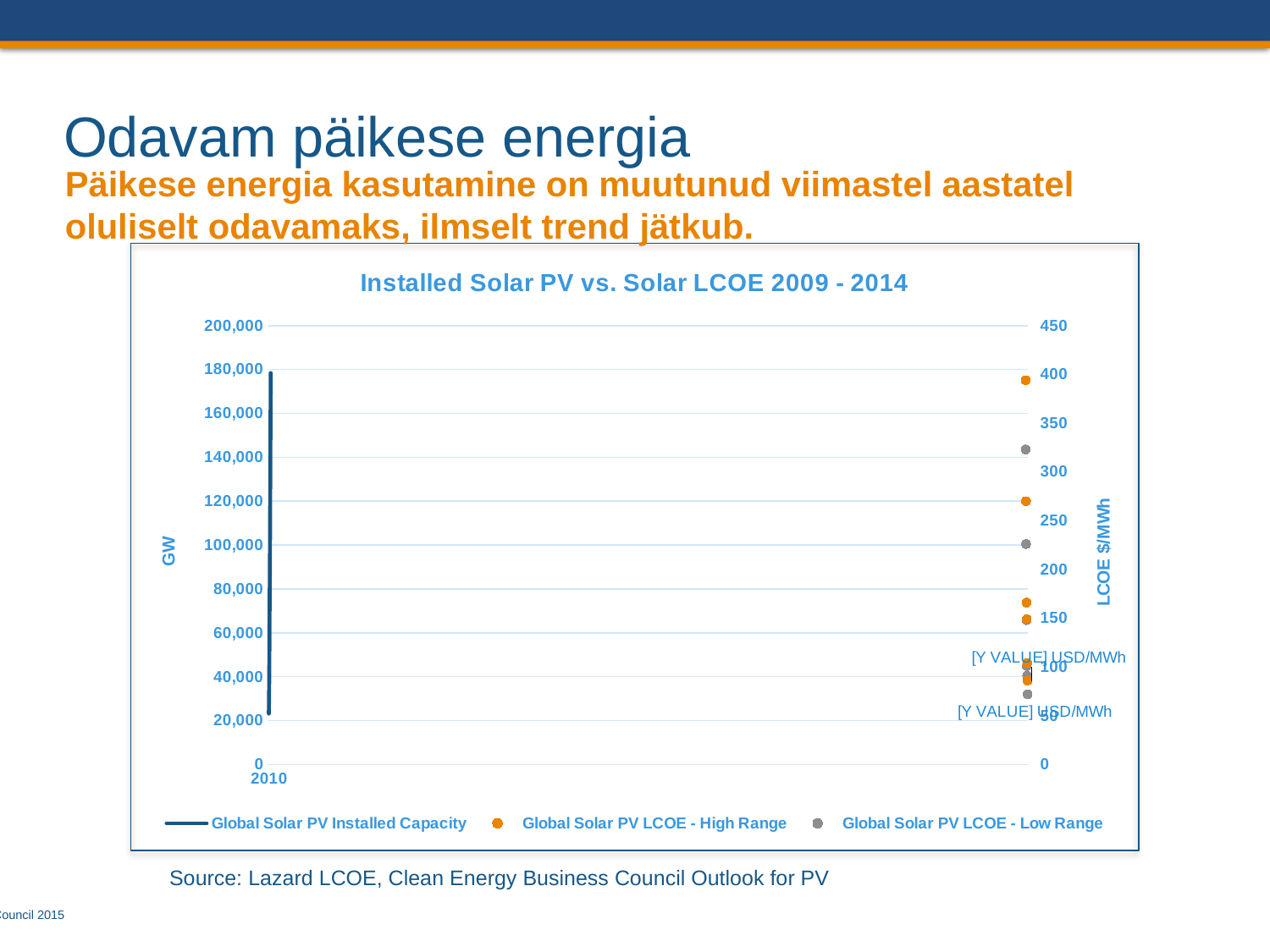
Which series has the highest plotted point on the right axis: Global Solar PV LCOE - High Range or Global Solar PV LCOE - Low Range? Global Solar PV LCOE - High Range Is the lowest Global Solar PV LCOE - Low Range point greater or less than 100 on the right axis? less Which colour marks the Global Solar PV LCOE - High Range series? Orange What is the title of the chart? Installed Solar PV vs. Solar LCOE 2009 - 2014 What is the only year label shown on the x axis? 2010 Is the top of the Global Solar PV Installed Capacity line greater or less than 160,000 on the left axis? greater Is the highest Global Solar PV LCOE - High Range point greater or less than 350 on the right axis? greater How many series does the chart legend list? 3 What is the maximum value shown on the right (LCOE $/MWh) axis? 450 What is the maximum value shown on the left (GW) axis? 200,000